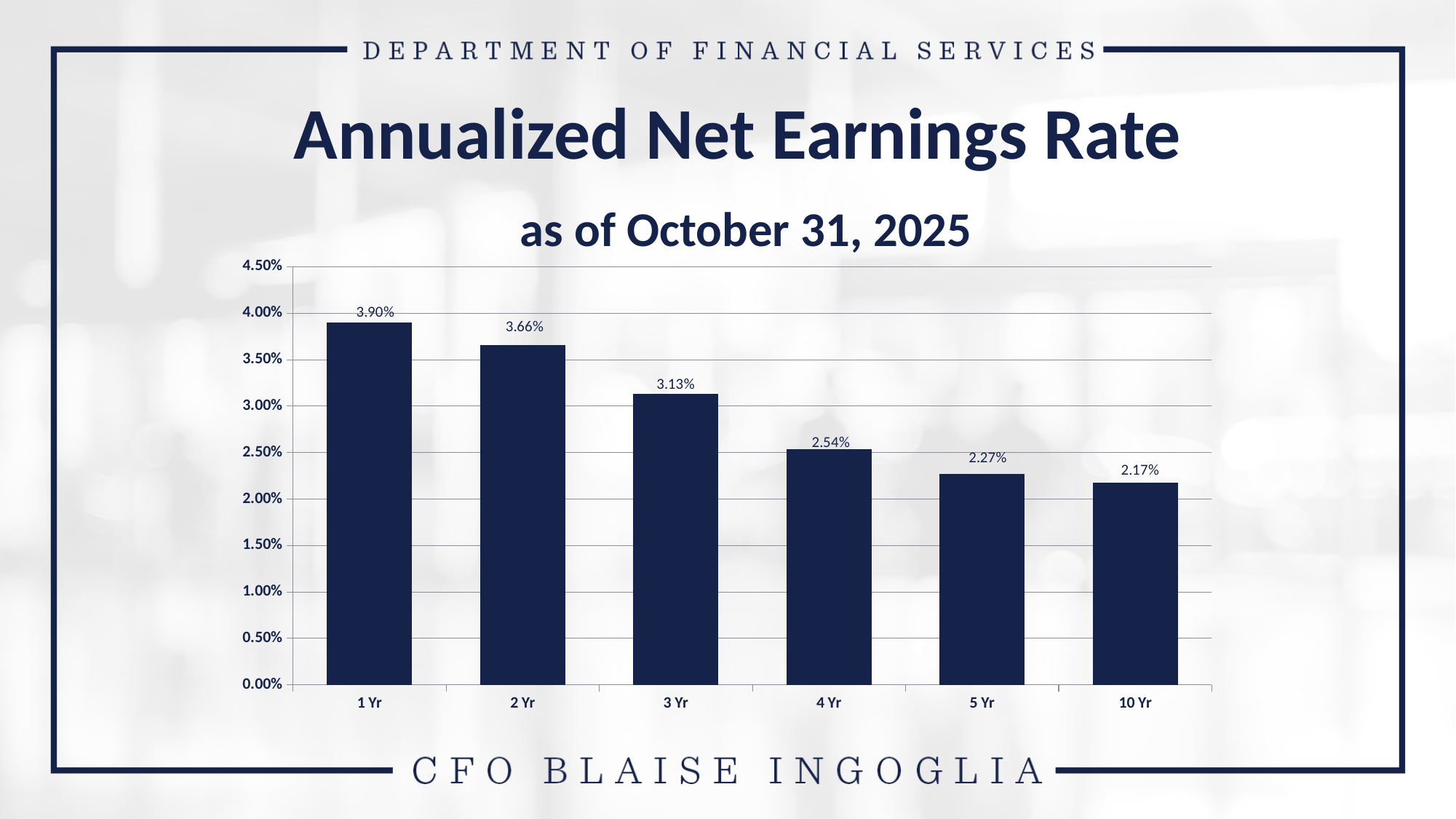
How many periods are shown on the x axis? 6 Which period has the lowest annualized net earnings rate? 10 Yr What is the annualized net earnings rate for 1 Yr? 3.90% What is the annualized net earnings rate for 3 Yr? 3.13% Which period has the highest annualized net earnings rate? 1 Yr What is the difference between the 1 Yr and 2 Yr annualized net earnings rates? 0.24% What is the difference between the 4 Yr and 5 Yr annualized net earnings rates? 0.27% What is the annualized net earnings rate for 10 Yr? 2.17% What kind of chart is shown on the slide? Bar chart Which is larger, the 3 Yr rate or the 4 Yr rate? 3 Yr Is the value for 2 Yr greater or less than 3.50%? greater Do the annualized net earnings rates rise or fall from 1 Yr to 10 Yr? Fall